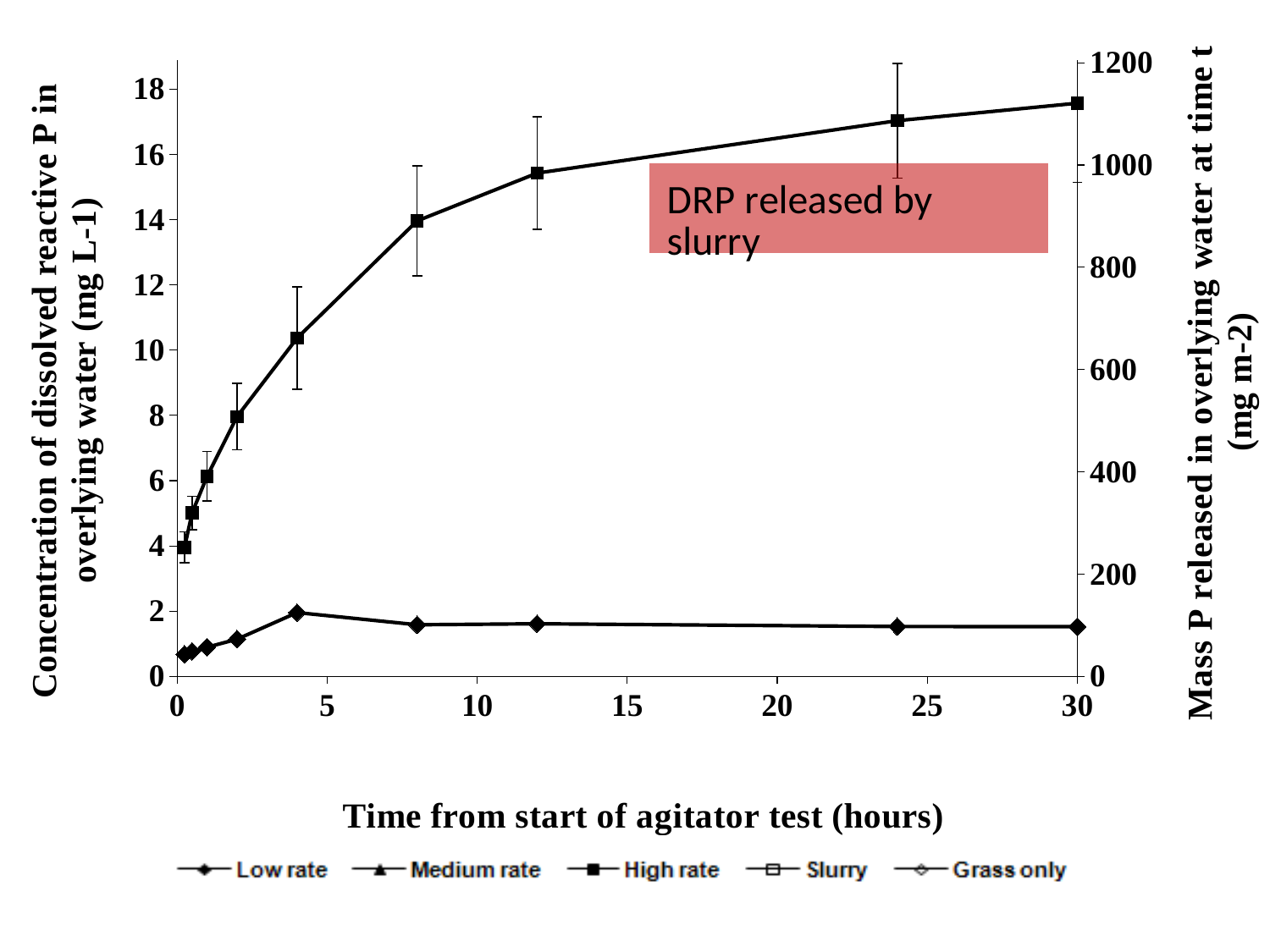
Is the value of the Low rate series (diamond markers) at 1 hour greater or less than 2 on the left axis? less Is the value of the Low rate series (diamond markers) at 30 hours greater or less than 2 on the left axis? less At 24 hours, which series has the higher value: High rate (square markers) or Low rate (diamond markers)? High rate Does the High rate series (square markers) rise or fall as time increases from 0 to 30 hours? rise Is the value of the High rate series (square markers) at 12 hours greater or less than 14 on the left axis? greater What text is written in the red box on the chart? DRP released by slurry How many series does the legend list? 5 What is the title of the x axis? Time from start of agitator test (hours) What kind of chart is shown on the slide? line chart What is the highest tick value shown on the right-hand y axis? 1200